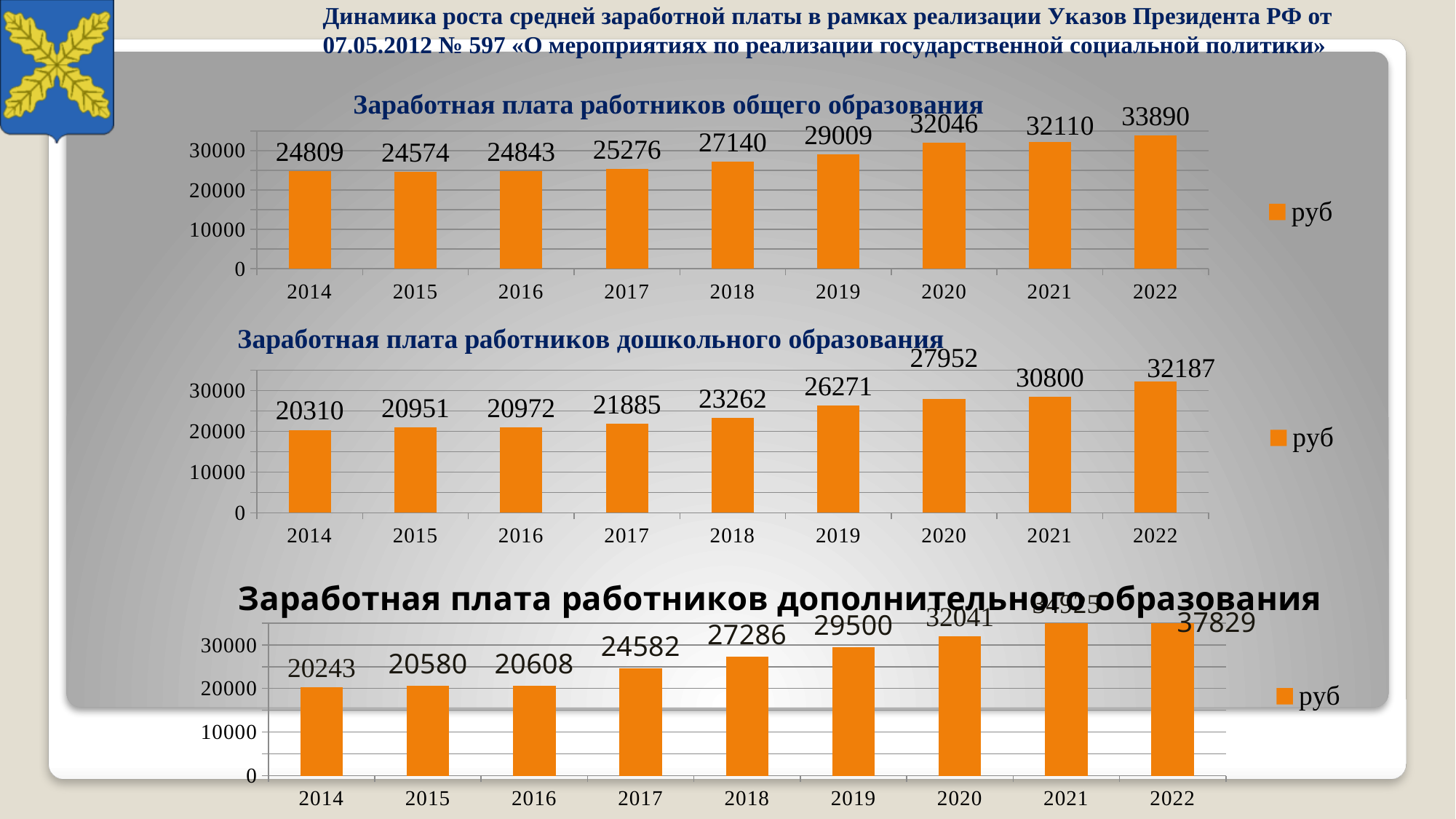
In the chart 'Заработная плата работников дошкольного образования', what is the value for 2019? 26271 How many series does the legend of the chart 'Заработная плата работников дошкольного образования' list? 1 In the chart 'Заработная плата работников дошкольного образования', which year has the highest value? 2022 In the chart 'Заработная плата работников общего образования', which year has the lowest value? 2015 In the chart 'Заработная плата работников дополнительного образования', do the values generally rise or fall from 2014 to 2022? rise What kind of chart is 'Заработная плата работников общего образования'? bar chart In the chart 'Заработная плата работников общего образования', what is the value for 2018? 27140 In the chart 'Заработная плата работников дополнительного образования', which is larger, the value for 2016 or the value for 2018? 2018 In the chart 'Заработная плата работников общего образования', what is the difference between the values for 2022 and 2014? 9081 In the chart 'Заработная плата работников дошкольного образования', how many years are shown on the x axis? 9 In the chart 'Заработная плата работников дополнительного образования', what is the value for 2017? 24582